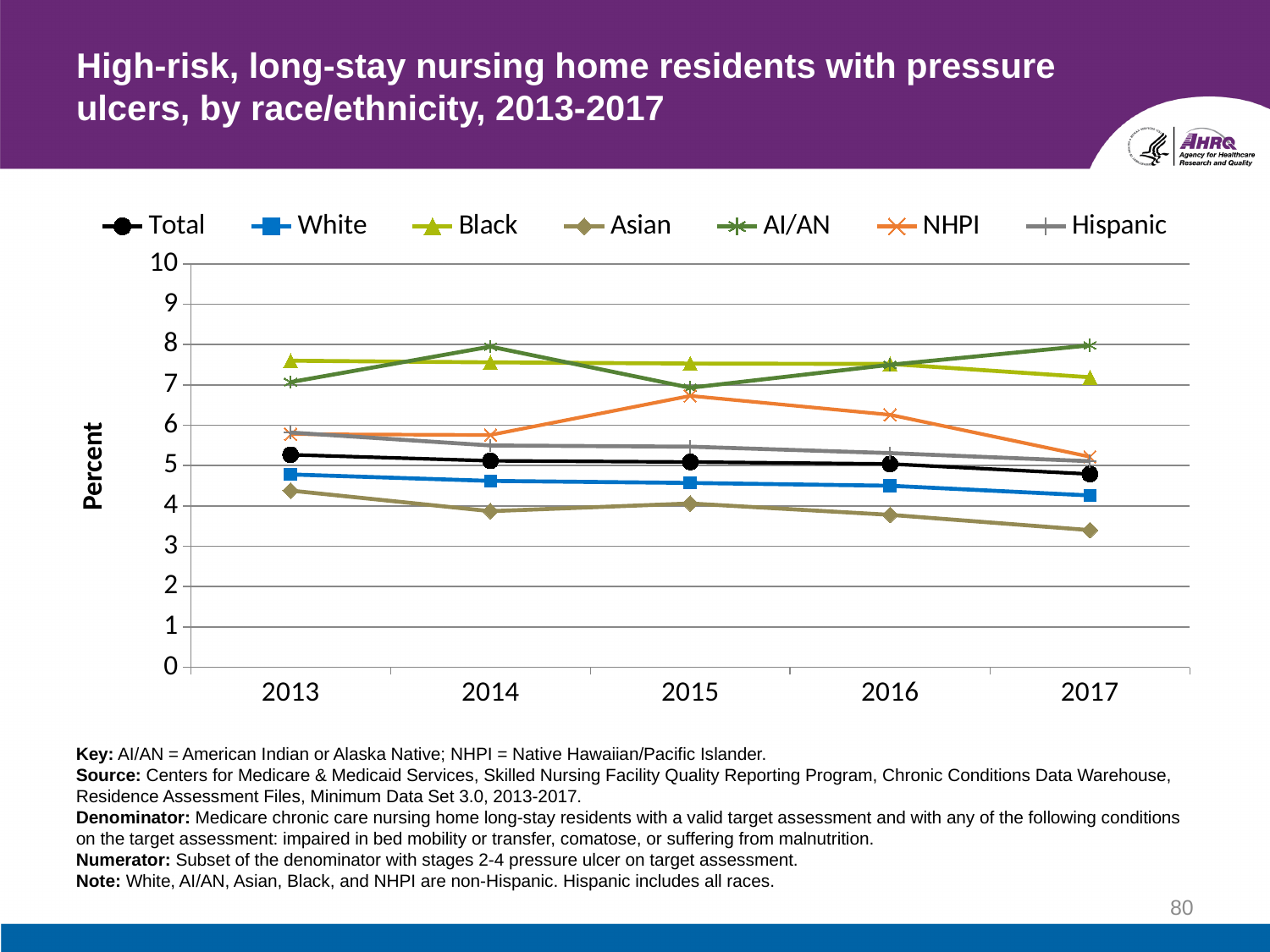
Is the value for Asian in 2017 greater or less than 4? less What kind of chart is shown on the slide? line chart What is the label on the y axis? Percent Is the value for Black in 2013 greater or less than 7? greater How many years are plotted along the x axis? 5 Which series has the lowest value in 2017? Asian Does the value for White rise or fall from 2013 to 2017? fall How many series does the legend list? 7 Does the value for Asian rise or fall from 2013 to 2017? fall Which series has the highest value in 2014? AI/AN Is the value for NHPI in 2015 greater or less than 6? greater Which is larger in 2013, the value for Black or the value for White? Black